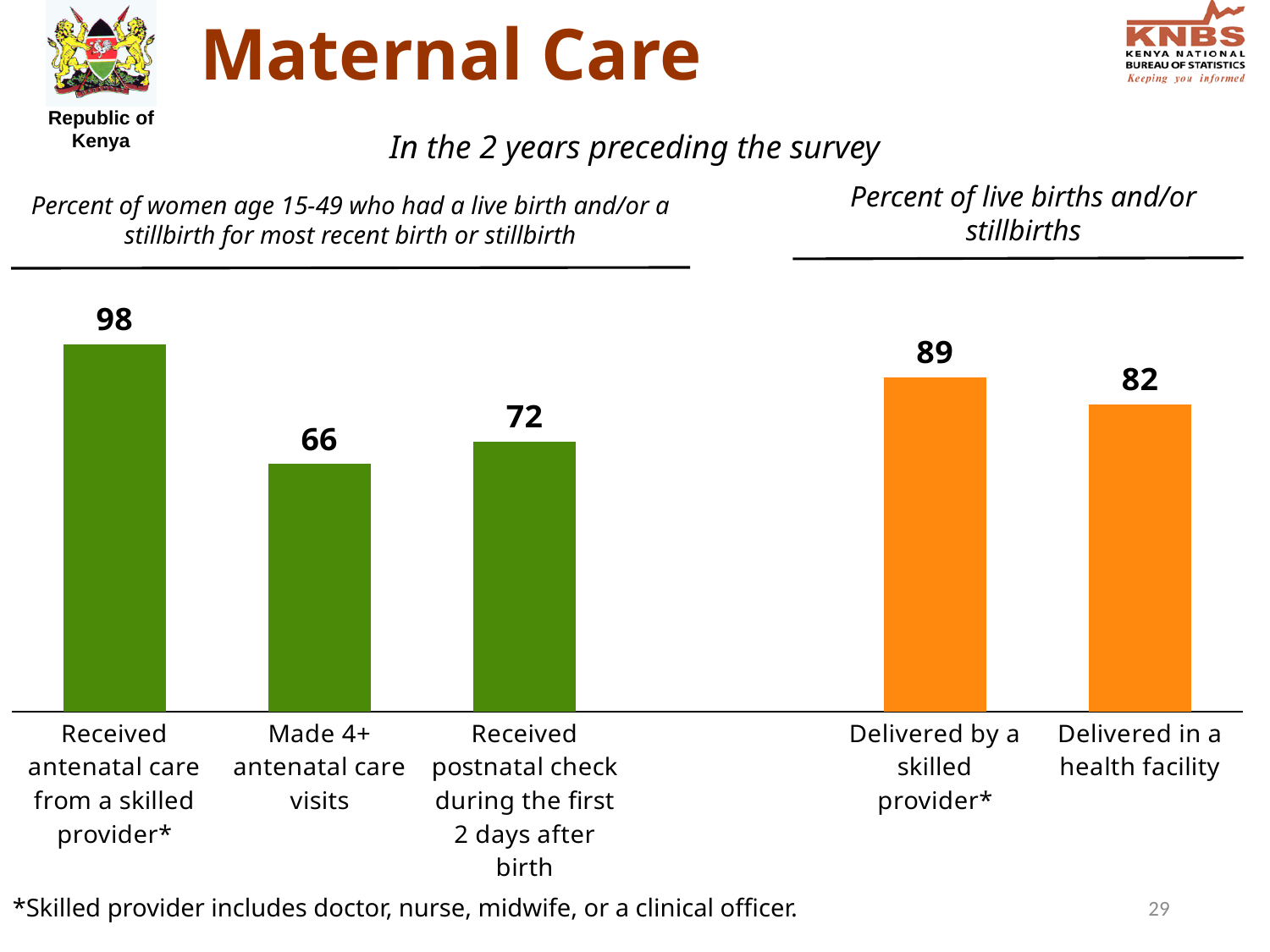
In the right chart, which is larger: 'Delivered by a skilled provider' or 'Delivered in a health facility'? Delivered by a skilled provider In the left chart, which category has the highest value? Received antenatal care from a skilled provider How many categories are shown in the left chart? 3 In the left chart, which category has the lowest value? Made 4+ antenatal care visits In the right chart, what is the difference between 'Delivered by a skilled provider' and 'Delivered in a health facility'? 7 In the right chart, what is the value for 'Delivered in a health facility'? 82 In the left chart, what is the difference between the value for 'Received antenatal care from a skilled provider' and the value for 'Made 4+ antenatal care visits'? 32 What kind of chart is the right chart (Percent of live births and/or stillbirths)? Bar chart In the right chart (Percent of live births and/or stillbirths), what is the value for 'Delivered by a skilled provider'? 89 In the left chart (Percent of women age 15-49 who had a live birth and/or a stillbirth), what is the value for 'Received antenatal care from a skilled provider'? 98 In the left chart, what is the value for 'Received postnatal check during the first 2 days after birth'? 72 In the left chart, what is the value for 'Made 4+ antenatal care visits'? 66